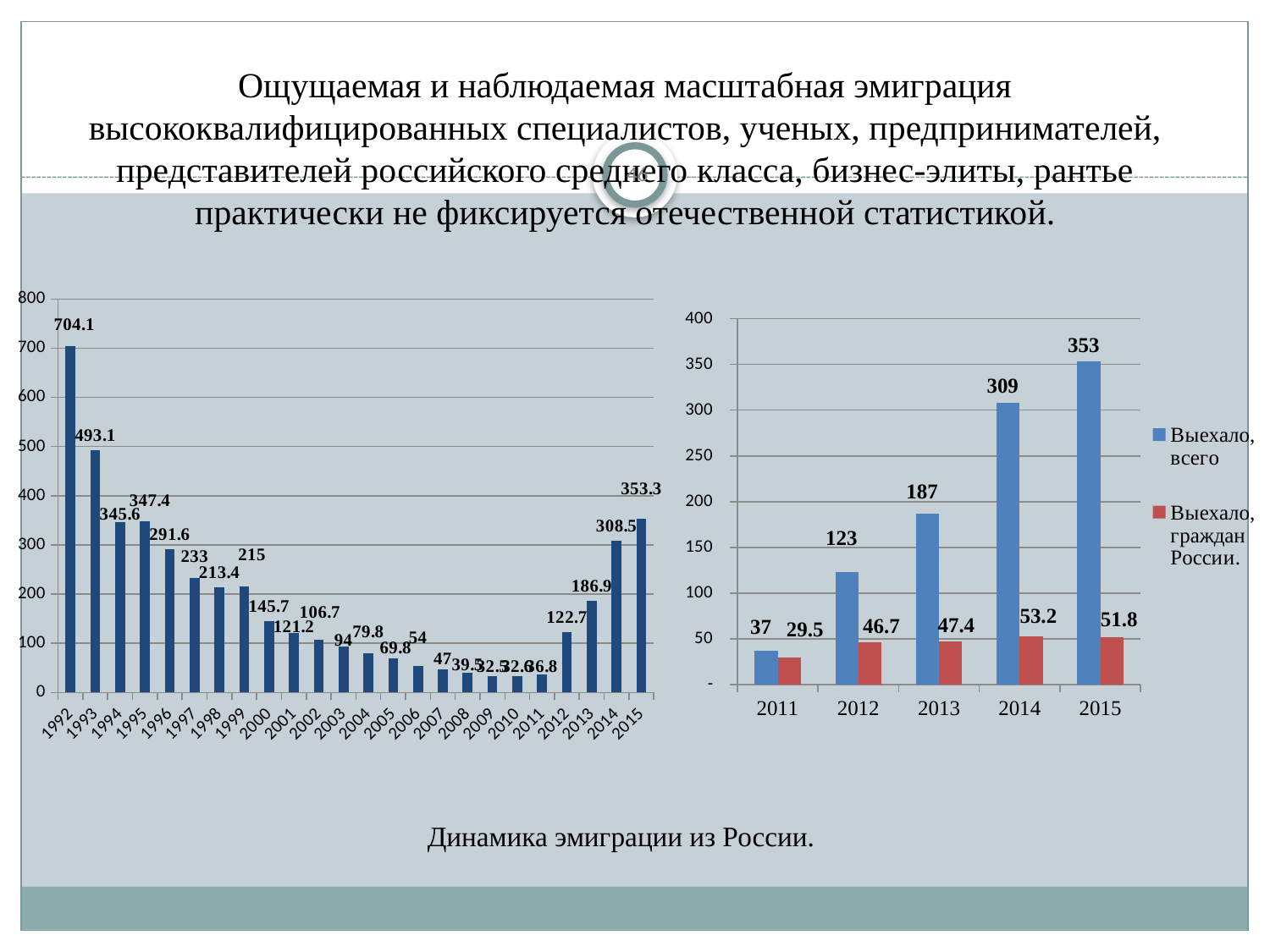
In the left chart, how many years are shown on the x axis? 24 In the right chart, what is the value of 'Выехало, всего' for 2014? 309 In the left chart, what is the value for 2015? 353.3 In the left chart, do the values rise or fall from 1992 to 2005? fall In the left chart, what is the difference between the values for 2014 and 2013? 121.6 In the right chart, what is the value of 'Выехало, граждан России.' for 2012? 46.7 In the right chart, what is the difference between 'Выехало, всего' and 'Выехало, граждан России.' in 2015? 301.2 What kind of chart is the right chart? bar chart In the left chart, which year has the highest value? 1992 In the right chart, how many series does the legend list? 2 In the left chart, which is larger, the value for 1994 or the value for 1995? 1995 In the left chart, what is the value for 1992? 704.1